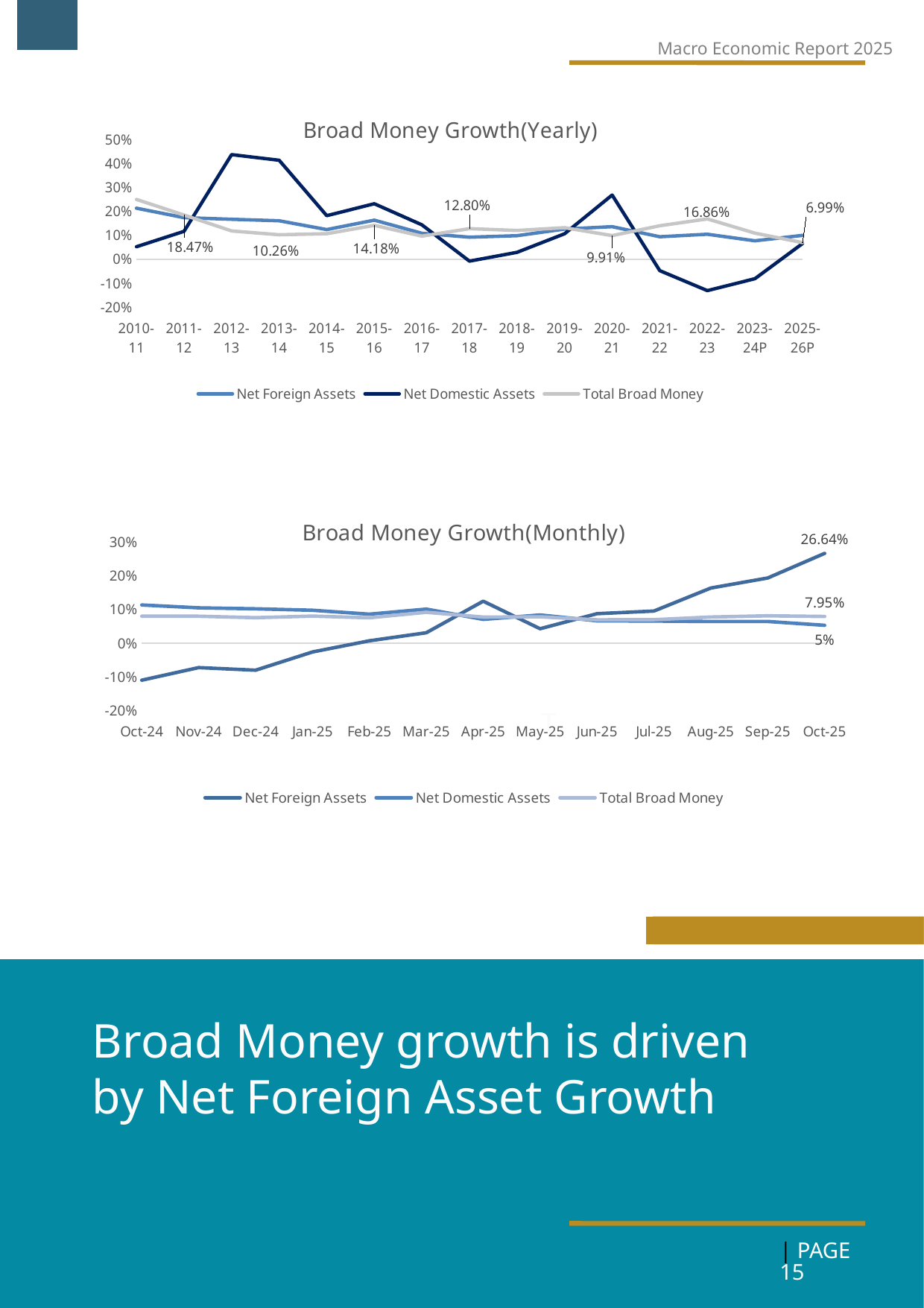
How many time periods are shown on the x axis of the 'Broad Money Growth(Monthly)' chart? 13 In the 'Broad Money Growth(Yearly)' chart, is the Net Domestic Assets value for 2012-13 greater or less than 30%? greater In the 'Broad Money Growth(Yearly)' chart, what is the labelled value for 2025-26P? 6.99% In the 'Broad Money Growth(Yearly)' chart, what is the labelled Total Broad Money value for 2011-12? 18.47% In the 'Broad Money Growth(Monthly)' chart, is the Net Foreign Assets value for Oct-24 greater or less than 0%? less In the 'Broad Money Growth(Yearly)' chart, what is the difference between the labelled values for 2011-12 (18.47%) and 2013-14 (10.26%)? 8.21% What type of chart is the 'Broad Money Growth(Yearly)' chart? line chart How many series does the legend of the 'Broad Money Growth(Yearly)' chart list? 3 In the 'Broad Money Growth(Monthly)' chart, what is the labelled Net Foreign Assets value for Oct-25? 26.64% In the 'Broad Money Growth(Yearly)' chart, which year has the highest Net Domestic Assets value? 2012-13 In the 'Broad Money Growth(Yearly)' chart, which year has the lowest Net Domestic Assets value? 2022-23 In the 'Broad Money Growth(Monthly)' chart, does the Net Foreign Assets line rise or fall from Oct-24 to Oct-25? rise